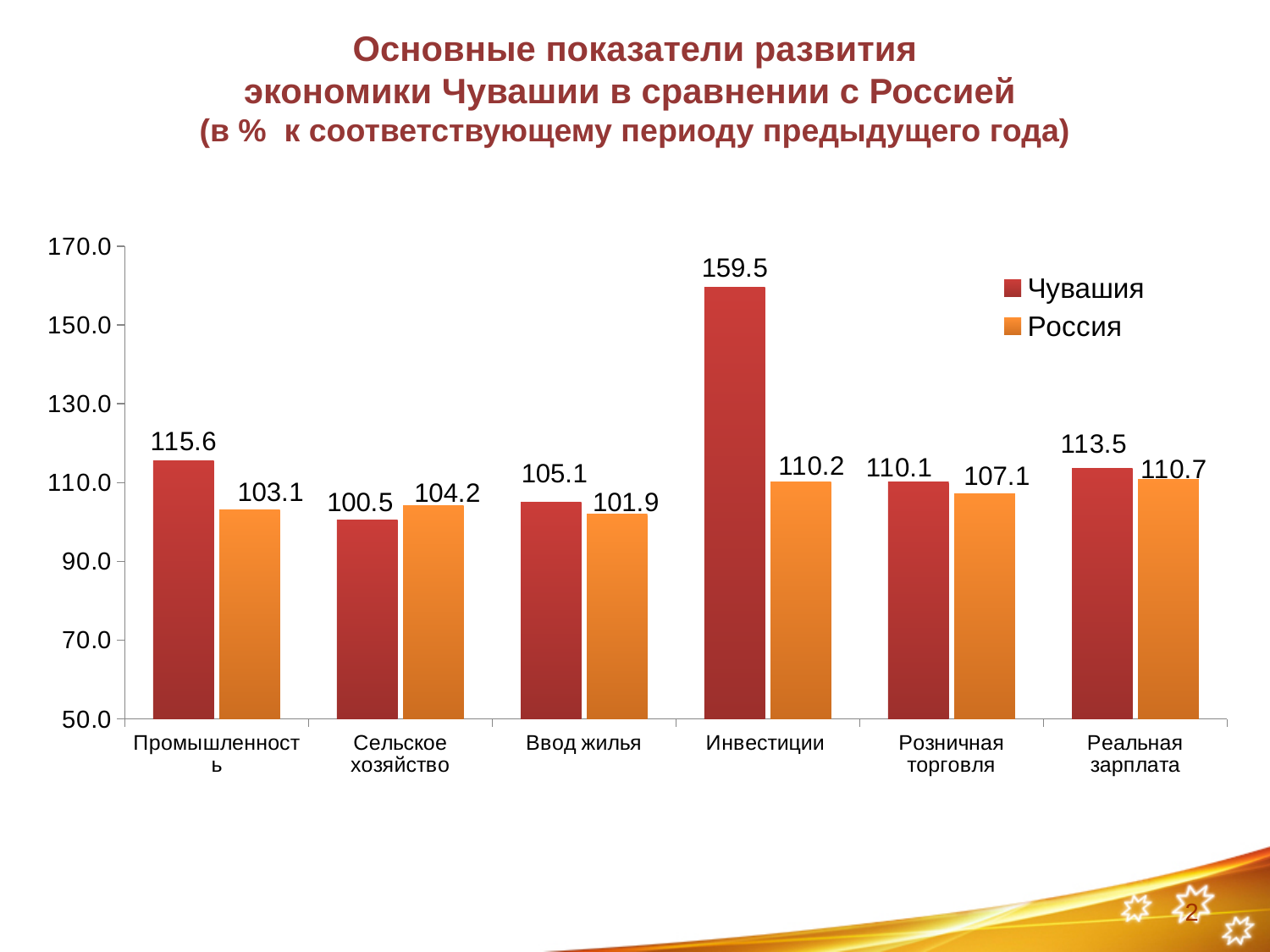
What is the difference between the Чувашия and Россия values in the Инвестиции category? 49.3 Is the value for Чувашия in the Инвестиции category greater or less than 150.0? greater Which category has the lowest value for Чувашия? Сельское хозяйство What is the value for Россия in the Промышленность category? 103.1 What is the value for Чувашия in the Инвестиции category? 159.5 Which category has the lowest value for Россия? Ввод жилья What kind of chart is shown on the slide? bar chart How many series does the legend list? 2 What is the value for Чувашия in the Реальная зарплата category? 113.5 Which is larger in the Сельское хозяйство category, the value for Чувашия or for Россия? Россия How many categories are shown on the x axis? 6 Which category has the highest value for Чувашия? Инвестиции